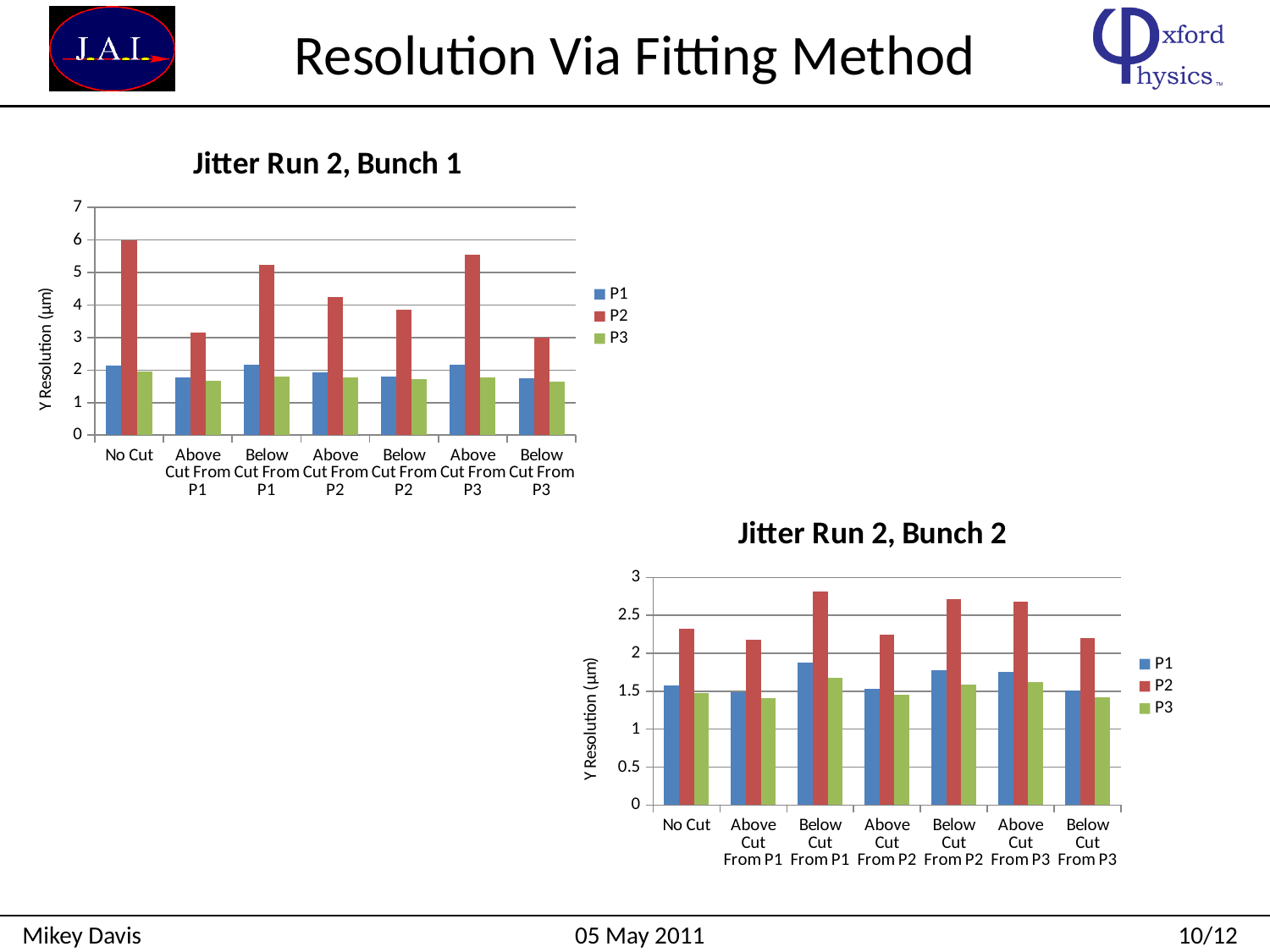
In "Jitter Run 2, Bunch 1", is the P2 value for No Cut greater or less than 5? greater What type of chart is "Jitter Run 2, Bunch 1"? bar chart In "Jitter Run 2, Bunch 1", which is larger for P2: Above Cut From P1 or Below Cut From P1? Below Cut From P1 In "Jitter Run 2, Bunch 2", which is larger for No Cut: P1 or P2? P2 In "Jitter Run 2, Bunch 2", is the P1 value for No Cut greater or less than 2? less In "Jitter Run 2, Bunch 1", which category has the highest P2 value? No Cut In "Jitter Run 2, Bunch 1", is the P2 value for Above Cut From P1 greater or less than 4? less How many categories are shown on the x axis of "Jitter Run 2, Bunch 1"? 7 How many series does the legend of "Jitter Run 2, Bunch 2" list? 3 What is the y-axis label of the "Jitter Run 2, Bunch 2" chart? Y Resolution (µm)